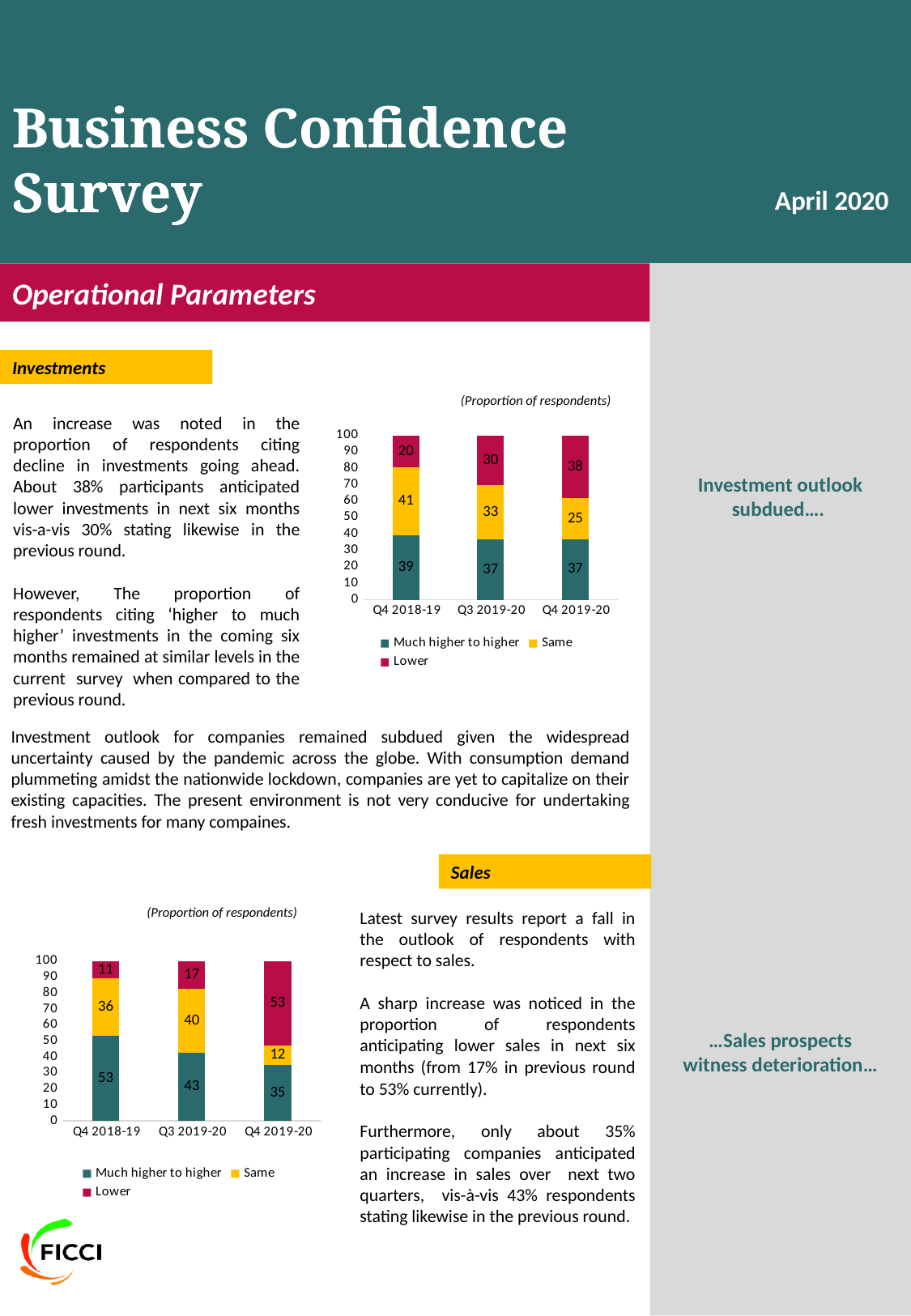
In the Sales chart, what is the value for 'Much higher to higher' in Q3 2019-20? 43 In the Investments chart, which quarter has the highest 'Lower' value? Q4 2019-20 In the Investments chart, what is the value for 'Same' in Q4 2018-19? 41 In the Sales chart, which quarter has the lowest 'Same' value? Q4 2019-20 In the Sales chart, how does the 'Much higher to higher' value change from Q4 2018-19 to Q4 2019-20? It falls In the Sales chart, is the 'Lower' value for Q4 2018-19 or Q3 2019-20 larger? Q3 2019-20 In the Sales chart, what is the value for 'Lower' in Q4 2019-20? 53 What type of chart is the Sales chart? Stacked bar chart In the Investments chart, what is the difference between the 'Same' values for Q4 2018-19 and Q4 2019-20? 16 How many series does the legend of the Investments chart list? 3 In the Investments chart, what is the value for 'Lower' in Q4 2019-20? 38 In the Investments chart, what is the total of the stacked bar for Q3 2019-20? 100